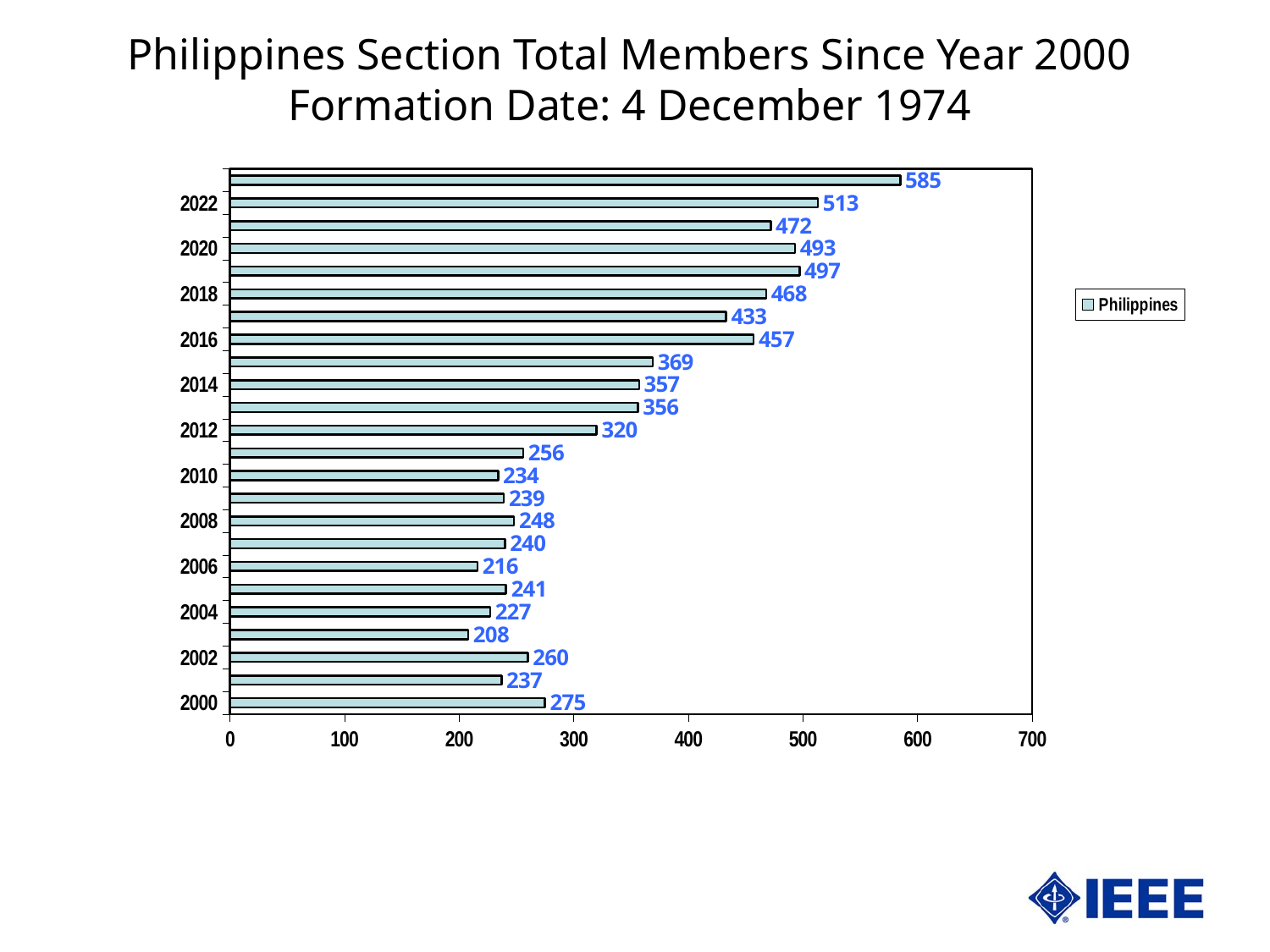
How many bars are plotted in the chart? 24 Which year has the highest value? 2023 What is the value for 2012? 320 Which year has the lowest value? 2003 What kind of chart is shown on the slide? bar chart What is the difference between the values for 2022 and 2020? 20 What is the value for 2000? 275 What is the value for 2016? 457 What series name does the legend show? Philippines What is the value for 2022? 513 Is the value for 2010 greater or less than 300? less Which is larger, the value for 2018 or the value for 2014? 2018